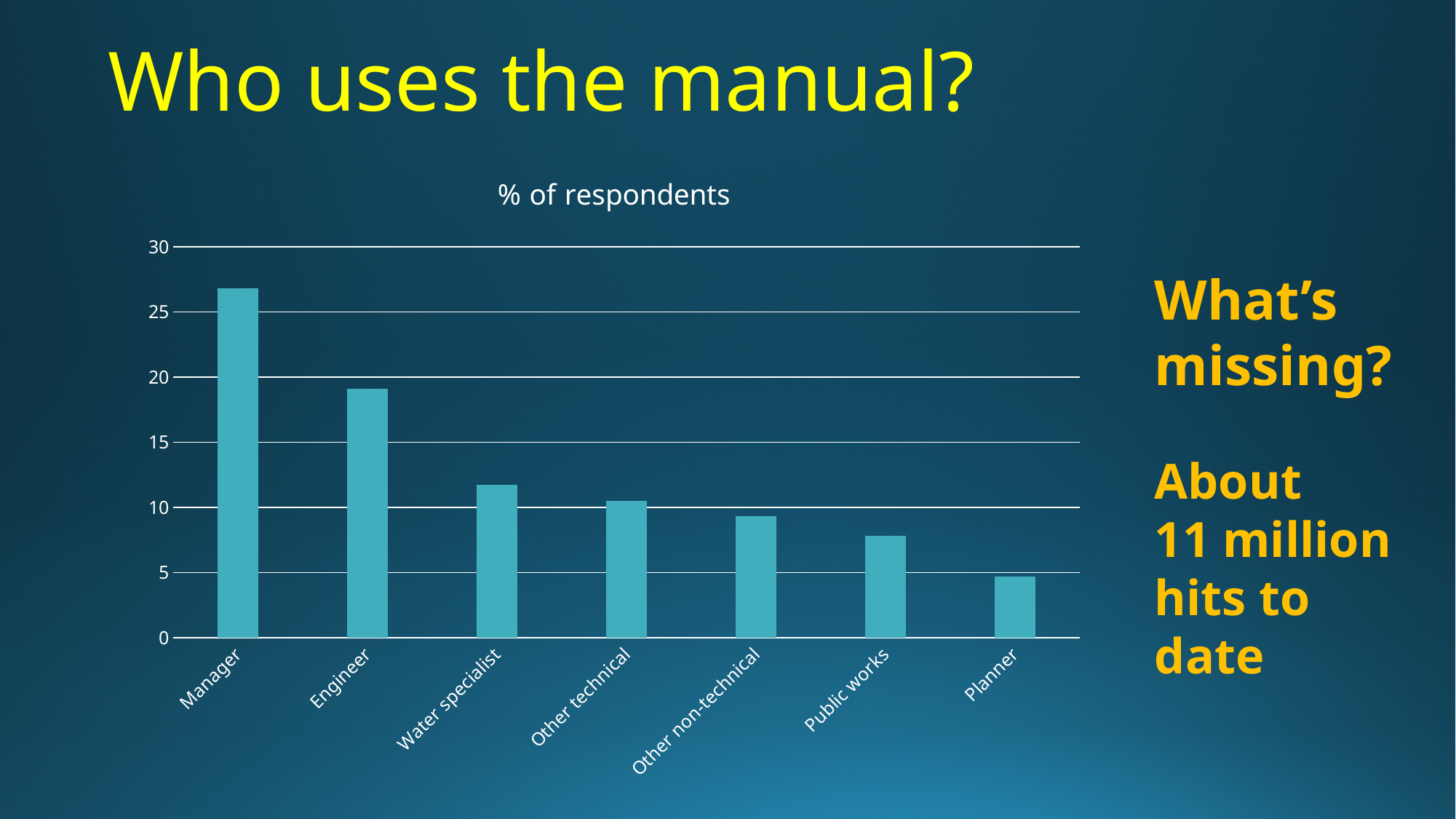
How many categories are shown on the x axis of the chart? 7 Which category has the highest value in the chart? Manager What is the title of the chart? % of respondents Which is larger, the value for Manager or the value for Engineer? Manager Is the value for Water specialist greater or less than 10? greater Is the value for Engineer greater or less than 20? less Which category has the lowest value in the chart? Planner Is the value for Public works greater or less than 10? less What kind of chart is shown on the slide? Bar chart Do the values rise or fall from left to right along the x axis? Fall Which is larger, the value for Water specialist or the value for Public works? Water specialist